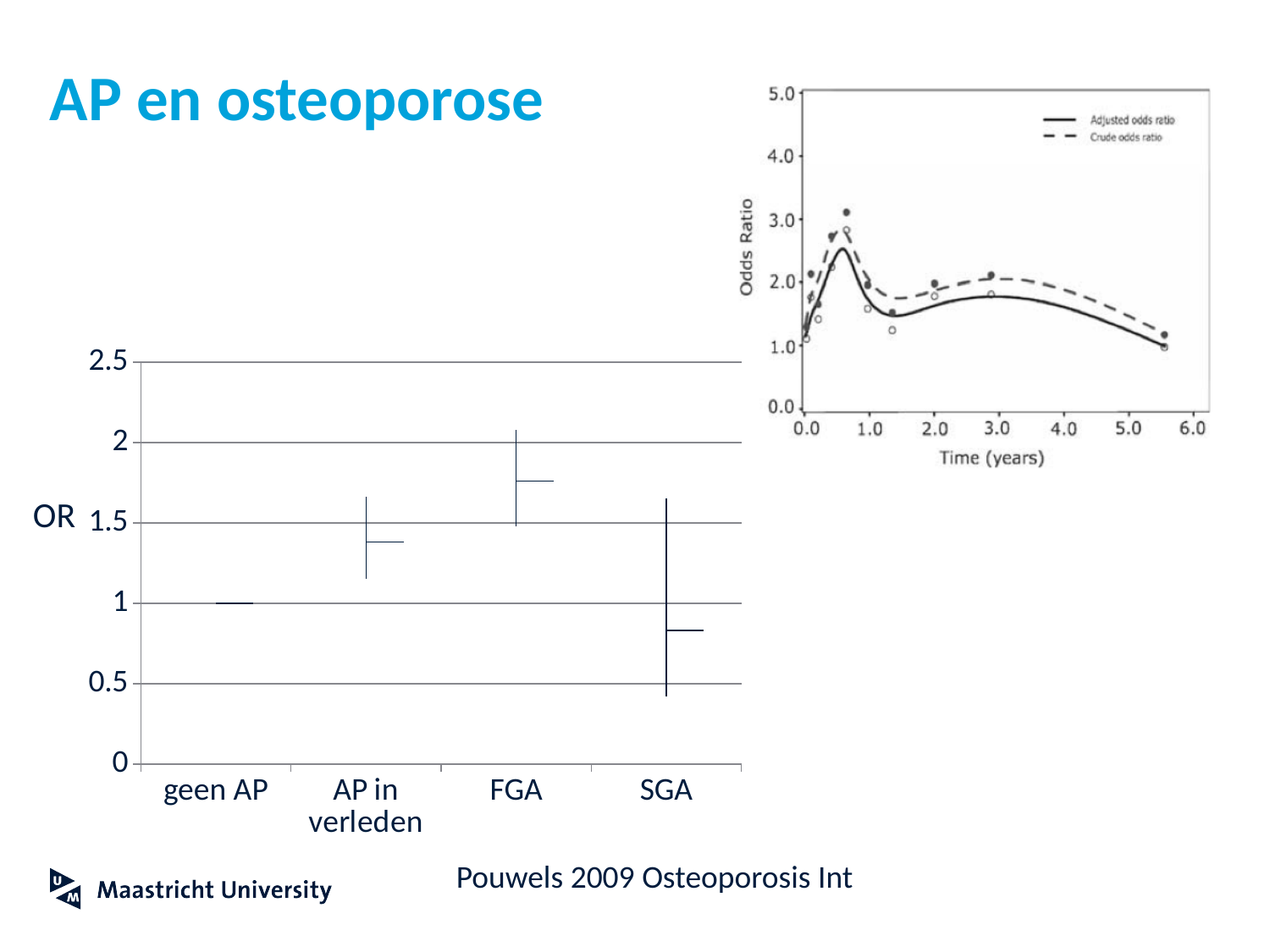
In the left chart (OR by antipsychotic group), what is the label on the y axis? OR In the right chart (Odds Ratio vs Time in years), how many series does the legend list? 2 In the left chart (OR by antipsychotic group), which has the larger OR point estimate, FGA or AP in verleden? FGA In the left chart (OR by antipsychotic group), is the OR point estimate for FGA greater or less than 1.5? greater In the left chart (OR by antipsychotic group), is the OR point estimate for AP in verleden greater or less than 1? greater In the left chart (OR by antipsychotic group), which category has the highest OR point estimate? FGA In the right chart (Odds Ratio vs Time in years), does the adjusted odds ratio line rise or fall between 3.0 and 5.5 years? fall In the left chart (OR by antipsychotic group), is the OR point estimate for SGA greater or less than 1? less In the left chart (OR by antipsychotic group), what is the OR value for geen AP? 1 In the left chart (OR by antipsychotic group), which category has the lowest OR point estimate? SGA In the left chart (OR by antipsychotic group), how many categories are shown on the x axis? 4 What kind of chart is the right chart (Odds Ratio vs Time in years)? line chart